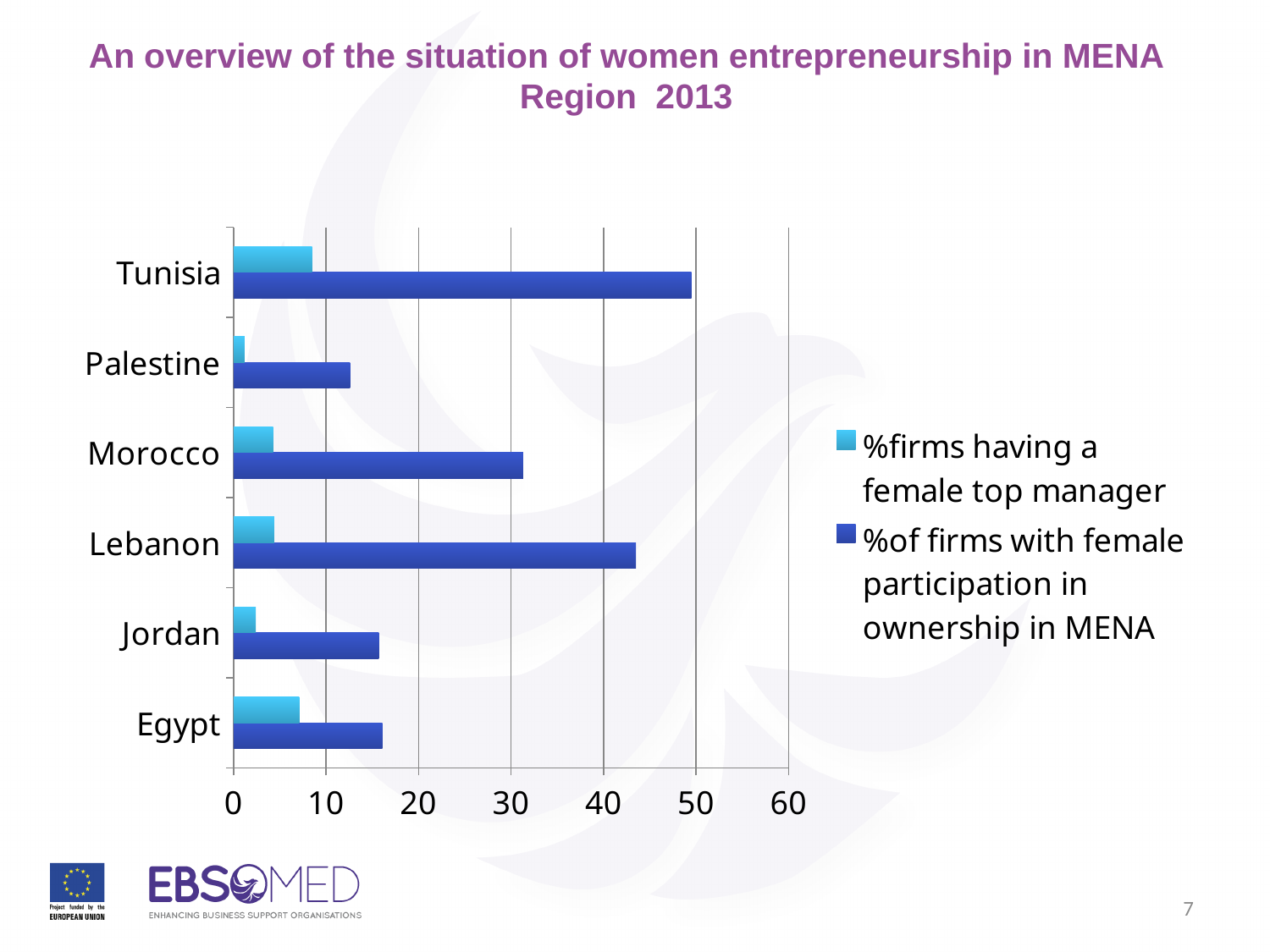
Which country has the lowest % of firms having a female top manager? Palestine What kind of chart is shown on the slide? bar chart Which is larger: the % of firms with female participation in ownership in Lebanon or in Morocco? Lebanon Is the % of firms with female participation in ownership for Jordan greater or less than 20? less Which country has the highest % of firms having a female top manager? Tunisia How many series does the legend list? 2 Is the % of firms having a female top manager for Egypt greater or less than 10? less Is the % of firms with female participation in ownership for Tunisia greater or less than 40? greater Which series is shown in dark blue in the legend? %of firms with female participation in ownership in MENA Which country has the highest % of firms with female participation in ownership? Tunisia Which country has the lowest % of firms with female participation in ownership? Palestine How many countries are shown on the chart? 6